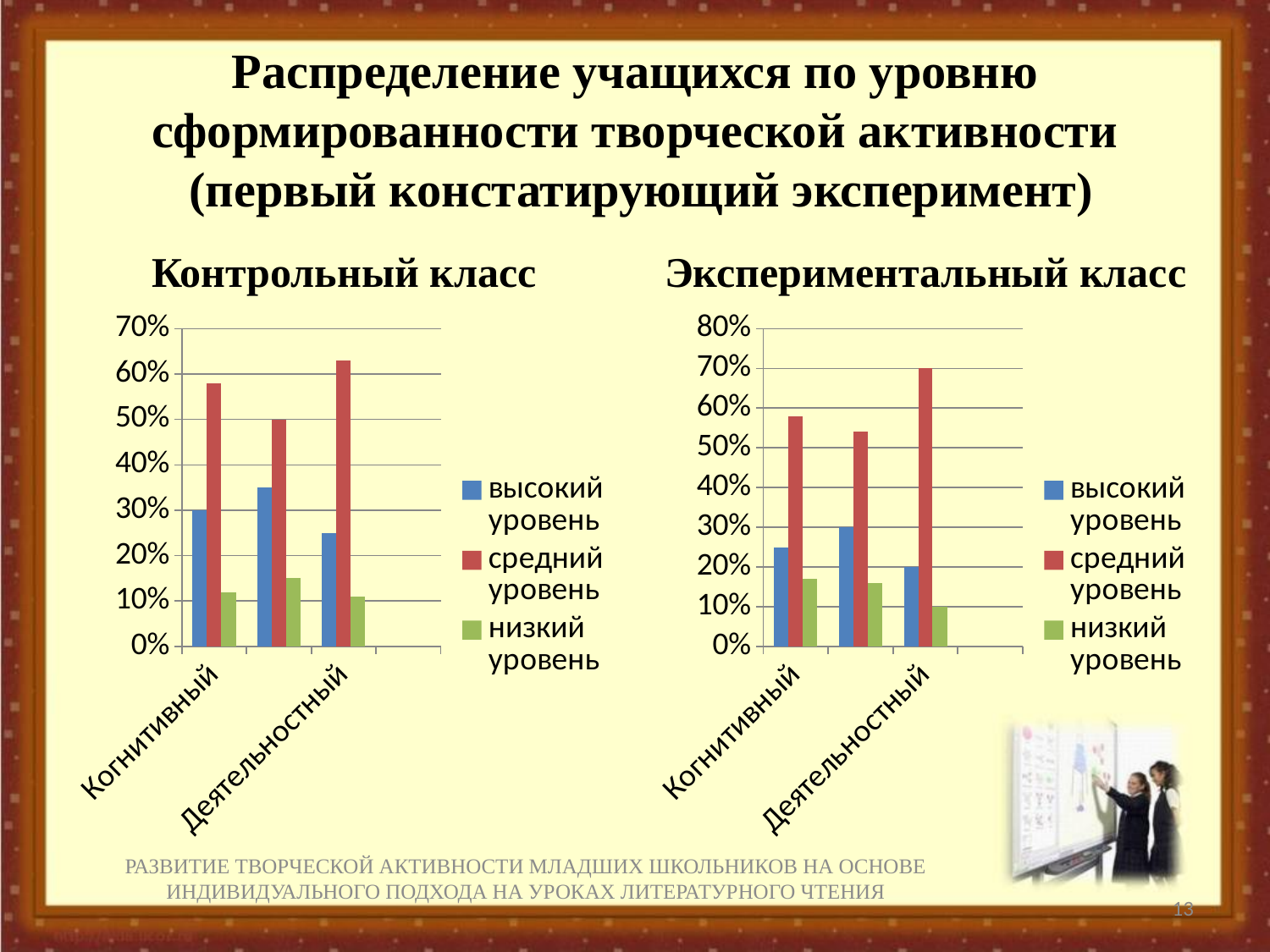
In the "Экспериментальный класс" chart, is the value of средний уровень for Когнитивный greater or less than 50%? greater In the "Контрольный класс" chart, which is larger for Когнитивный: высокий уровень or низкий уровень? высокий уровень How many series does the legend of the "Экспериментальный класс" chart list? 3 What kind of chart is the "Контрольный класс" chart? bar chart In the "Контрольный класс" chart, which series has the highest value for Когнитивный? средний уровень In the "Контрольный класс" chart, is the value of средний уровень for Когнитивный greater or less than 50%? greater In the "Экспериментальный класс" chart, is the value of низкий уровень for Когнитивный greater or less than 20%? less What colour are the bars for средний уровень in the "Контрольный класс" chart? red In the "Экспериментальный класс" chart, which series has the lowest value for Деятельностный? низкий уровень In the "Экспериментальный класс" chart, which is larger for Деятельностный: средний уровень or высокий уровень? средний уровень